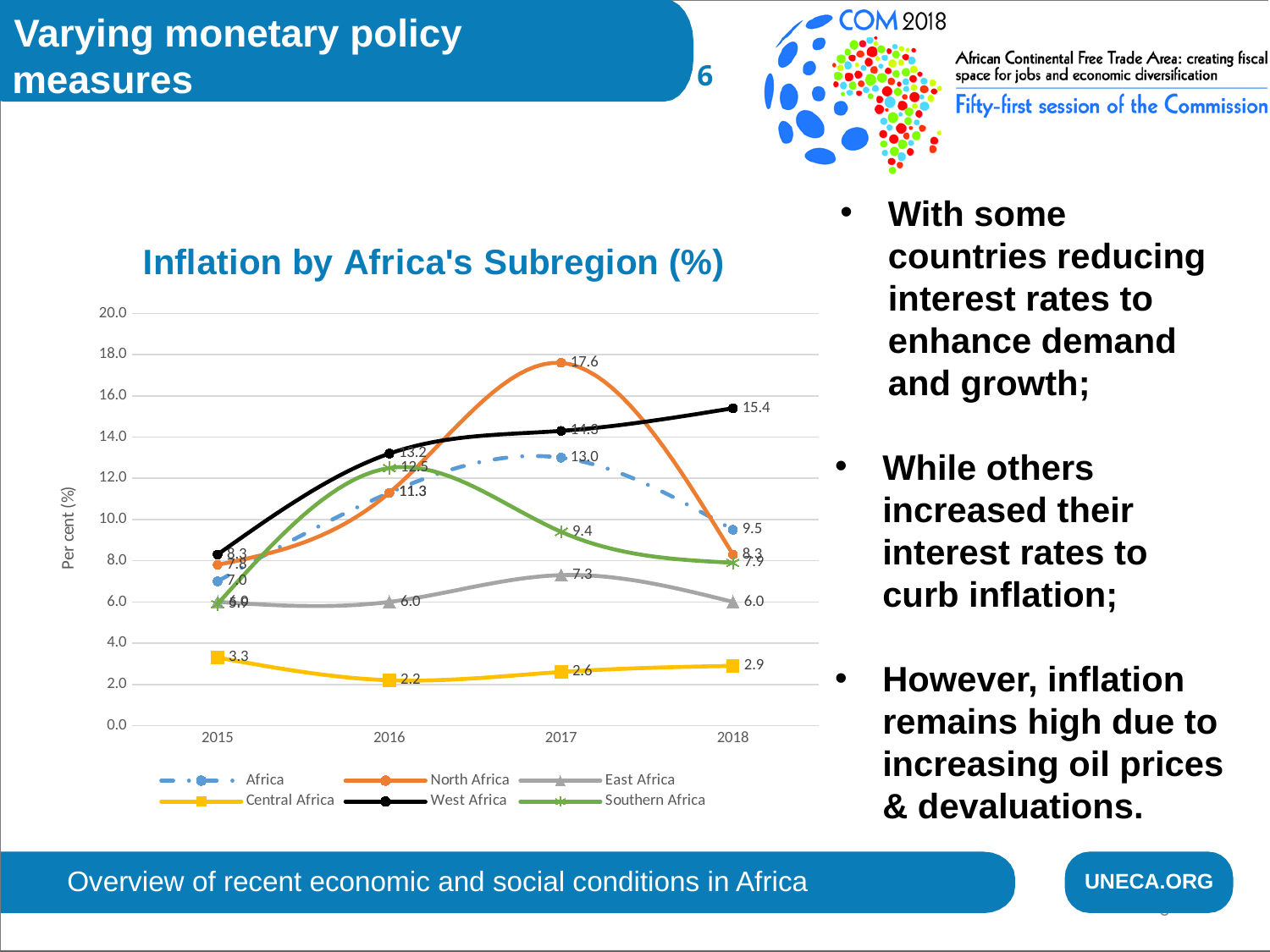
What kind of chart is shown on the slide? line chart What is the inflation value for North Africa in 2017? 17.6 Does the West Africa line rise or fall from 2015 to 2018? rises In 2018, which is higher: the inflation value for West Africa or for Africa? West Africa What is the inflation value for West Africa in 2018? 15.4 How many series does the legend of the 'Inflation by Africa's Subregion (%)' chart list? 6 Which subregion has the highest inflation in 2017? North Africa Which subregion has the lowest inflation in 2018? Central Africa What is the inflation value for Central Africa in 2016? 2.2 How many years are shown on the x axis of the chart? 4 What is the label on the y axis of the chart? Per cent (%) What is the difference between North Africa's inflation in 2017 and in 2018? 9.3